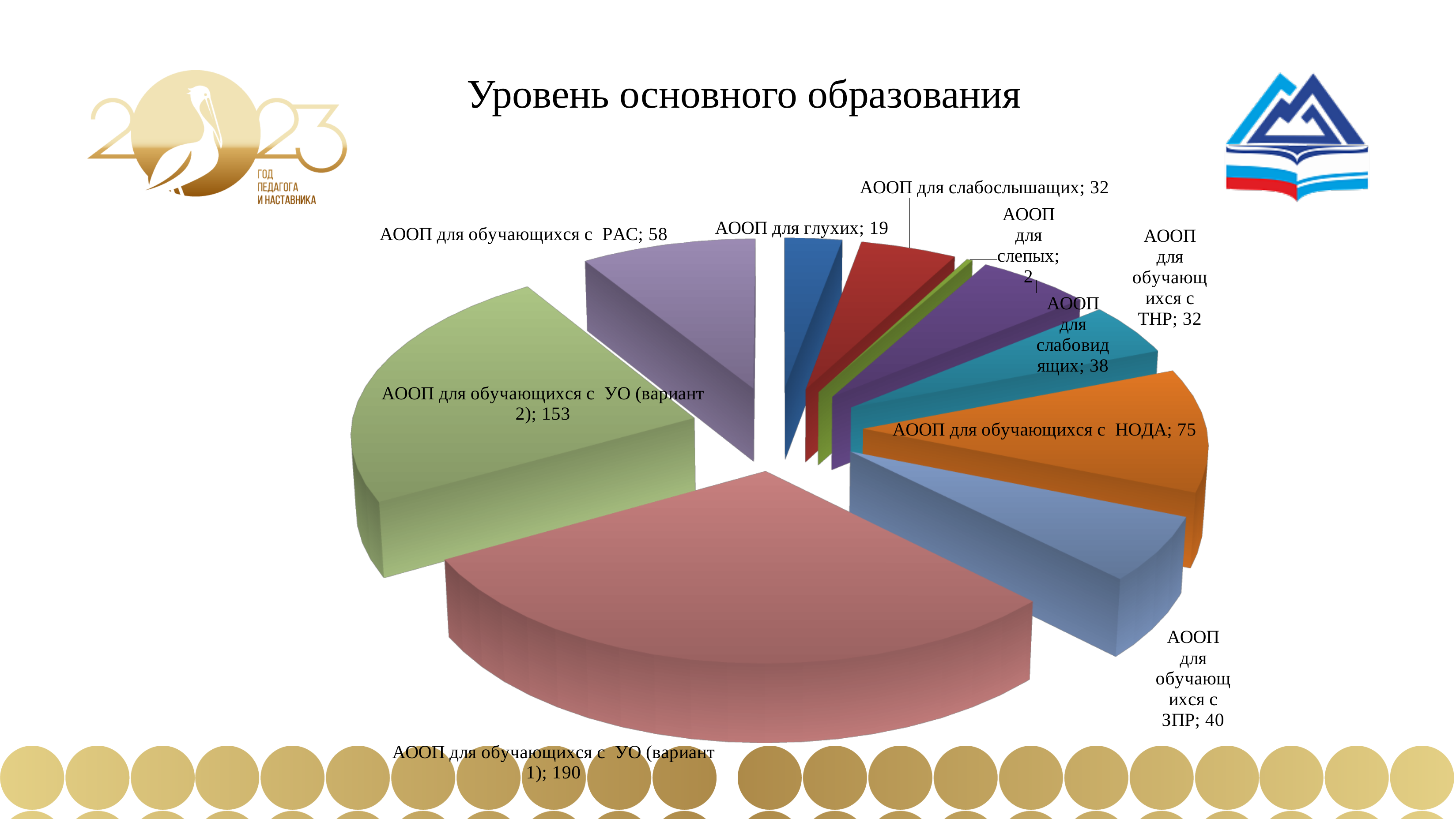
What is the value for АООП для обучающихся с РАС? 58 How many categories (slices) does the pie chart have? 10 What is the difference between the values for АООП для обучающихся с НОДА and АООП для обучающихся с РАС? 17 What is the value for АООП для обучающихся с НОДА? 75 Which is larger: the value for АООП для обучающихся с ЗПР or the value for АООП для слабовидящих? АООП для обучающихся с ЗПР What is the value for АООП для глухих? 19 What is the difference between the values for АООП для обучающихся с УО (вариант 1) and АООП для обучающихся с УО (вариант 2)? 37 Which category has the highest value? АООП для обучающихся с УО (вариант 1) What is the value for АООП для слабовидящих? 38 What is the title of the chart? Уровень основного образования What type of chart is shown on the slide? Pie chart Which category has the lowest value? АООП для слепых